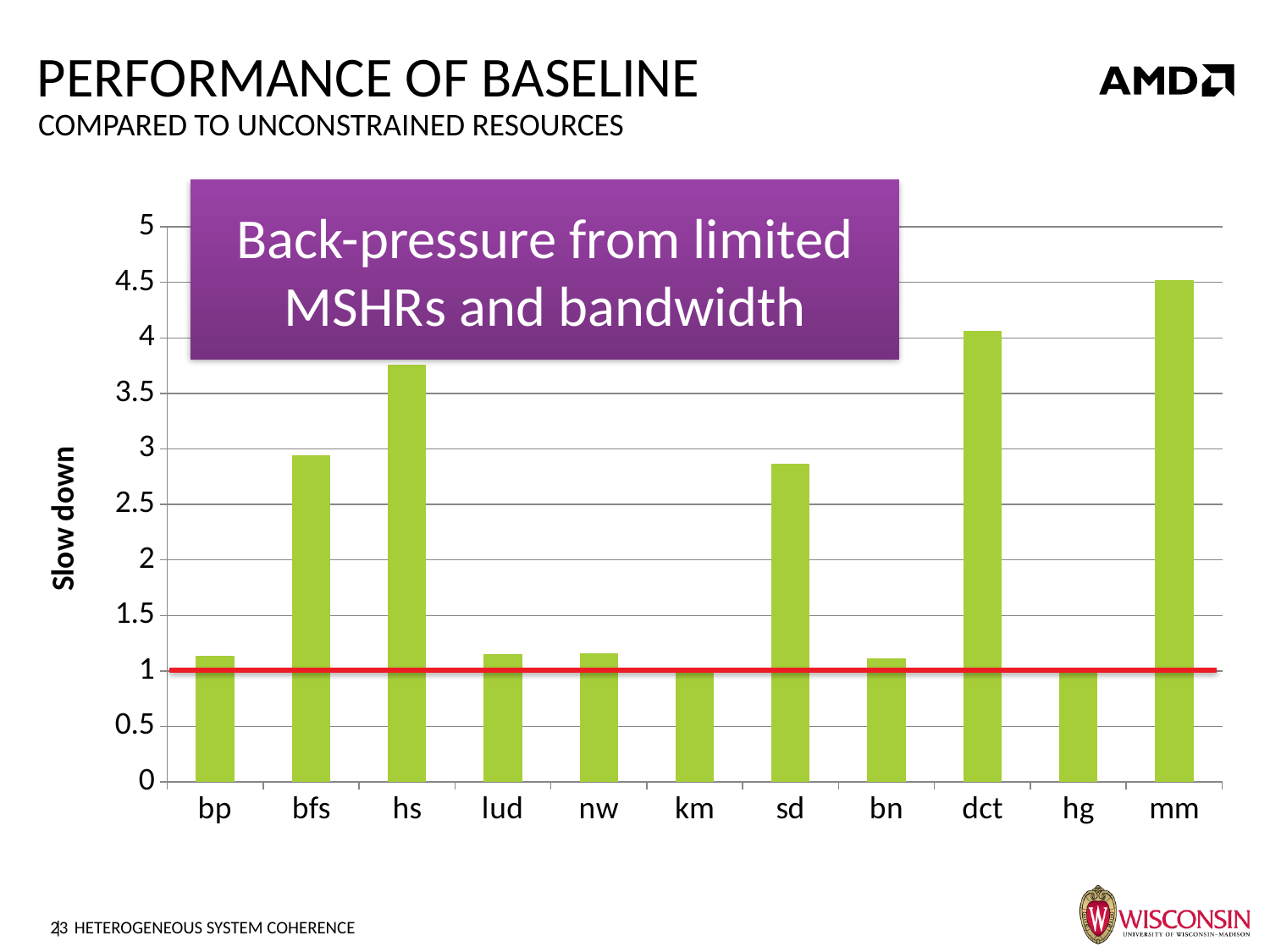
What is the label on the y axis? Slow down Is the value for hs greater or less than 3.5? greater Is the value for mm greater or less than 4? greater Is the value for bp greater or less than 1.5? less Which has the larger slow down, mm or dct? mm Which has the larger slow down, hs or bfs? hs Which category has the highest slow down? mm How many categories are plotted along the x axis? 11 What kind of chart is shown on the slide? bar chart